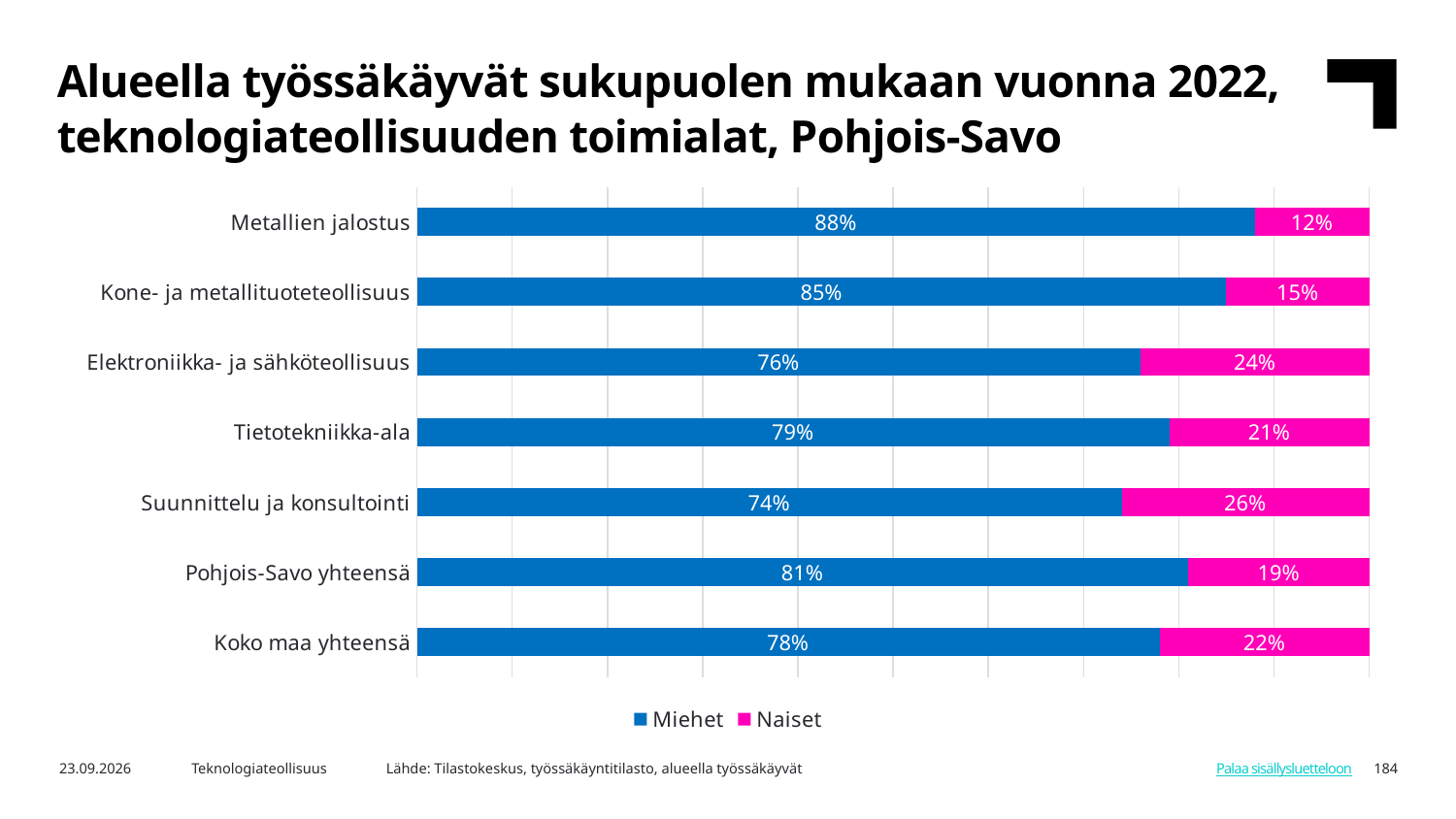
Which category has the highest Naiset share? Suunnittelu ja konsultointi What is the Miehet share for Koko maa yhteensä? 78% What is the Miehet share for Metallien jalostus? 88% What is the Naiset share for Suunnittelu ja konsultointi? 26% How many series does the legend list? 2 Which category has the lowest Miehet share? Suunnittelu ja konsultointi What kind of chart is shown on the slide? Stacked bar chart What is the total of the stacked bar for Kone- ja metallituoteteollisuus? 100% How many categories are shown on the chart? 7 What is the difference between the Miehet share for Metallien jalostus and for Tietotekniikka-ala? 9 percentage points Which is larger: the Naiset share for Elektroniikka- ja sähköteollisuus or for Tietotekniikka-ala? Elektroniikka- ja sähköteollisuus What is the Naiset share for Pohjois-Savo yhteensä? 19%